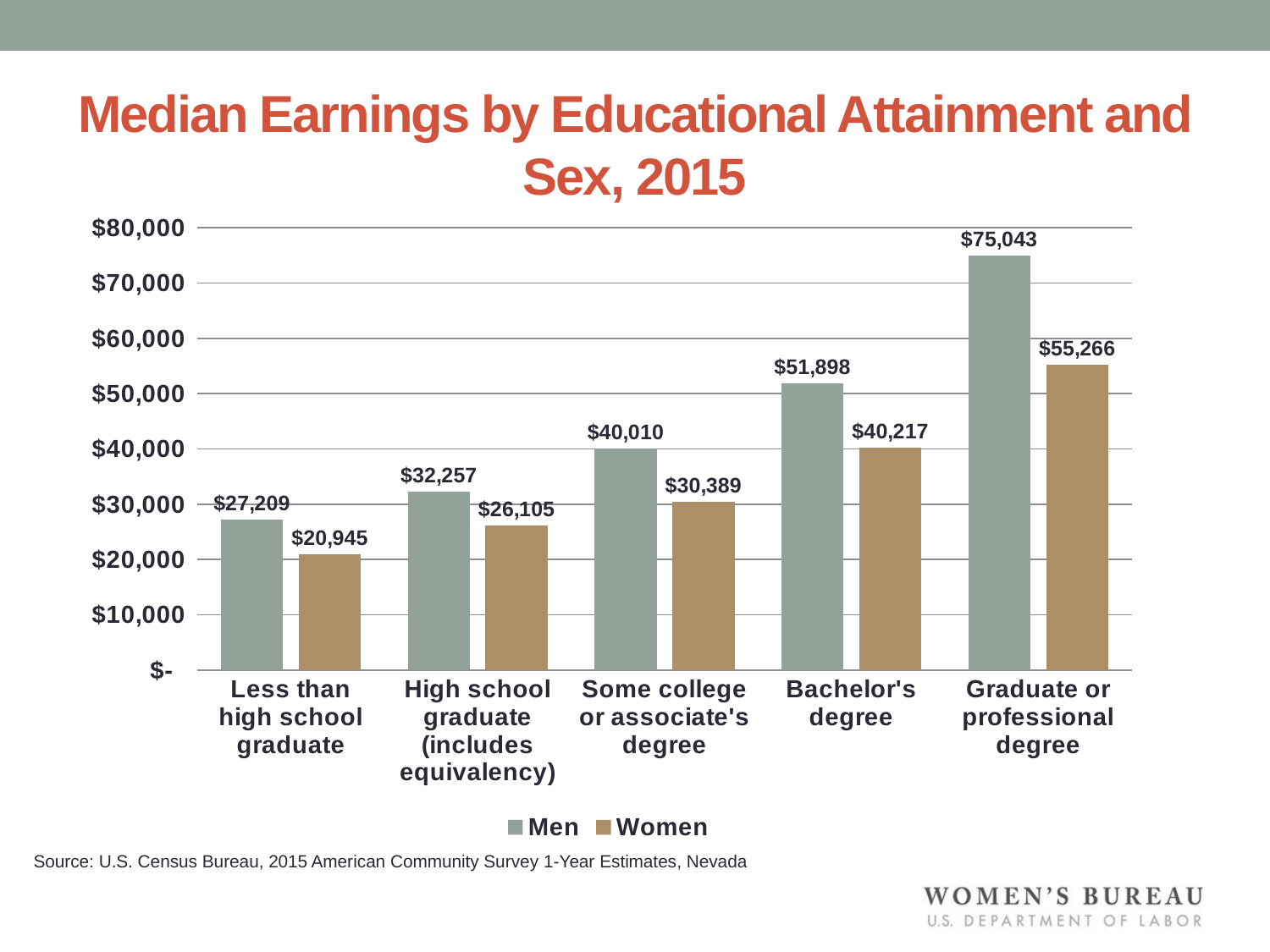
What are the median earnings for women who are high school graduates (includes equivalency)? $26,105 How many educational attainment categories are shown on the x axis? 5 What is the difference between men's and women's median earnings for those with less than a high school diploma? $6,264 Which educational attainment category has the lowest median earnings for women? Less than high school graduate Do men's median earnings rise or fall as educational attainment increases along the x axis? Rise Which educational attainment category has the highest median earnings for men? Graduate or professional degree What kind of chart is shown on the slide? Bar chart What are the median earnings for women with a graduate or professional degree? $55,266 What is the difference between men's and women's median earnings for those with a graduate or professional degree? $19,777 Which is larger: women's median earnings with a bachelor's degree or men's median earnings with some college or associate's degree? Women's median earnings with a bachelor's degree How many series does the legend list? 2 What are the median earnings for men with a bachelor's degree? $51,898